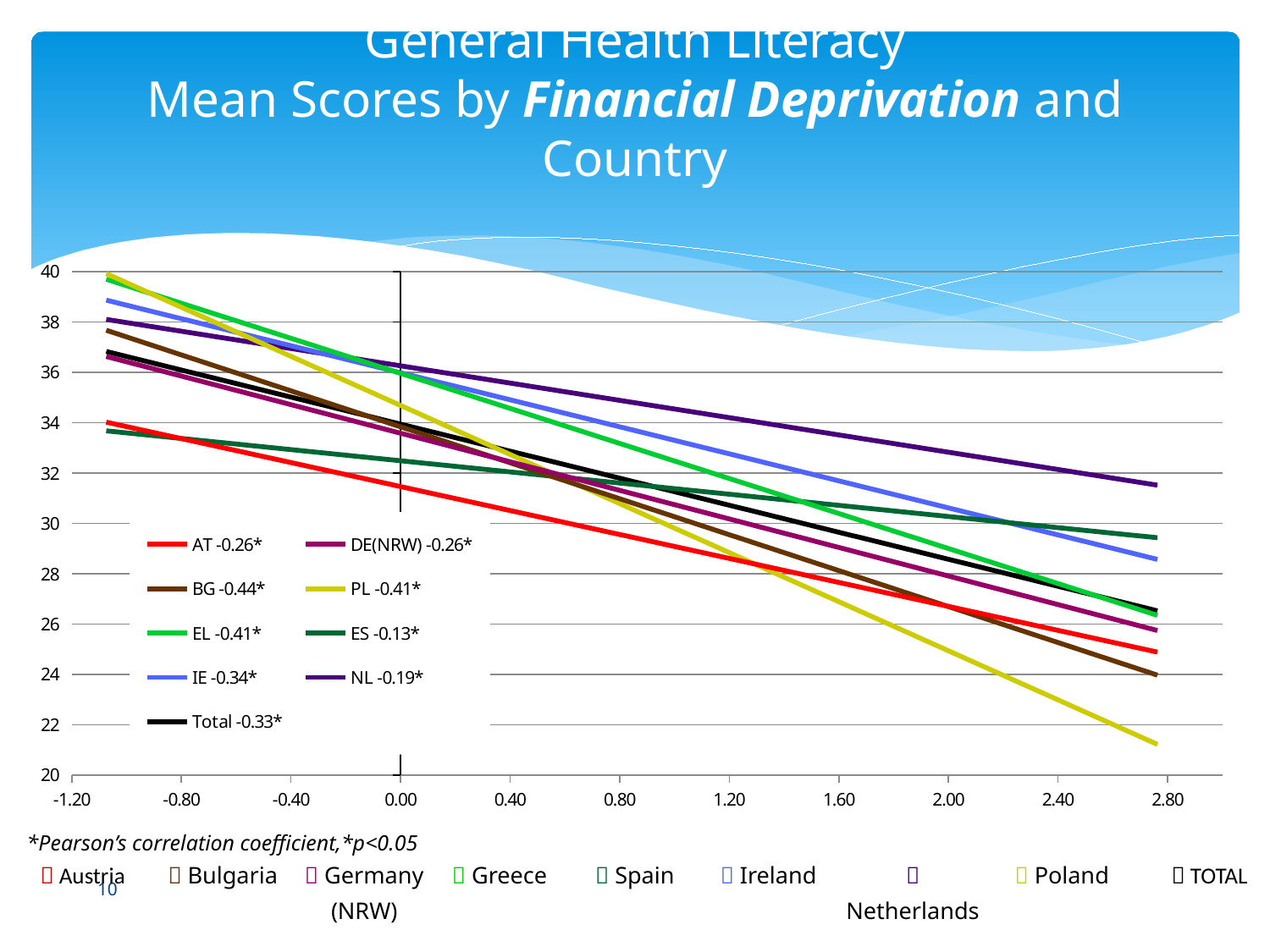
At the right end of the chart, which line is higher: ES or AT? ES Is the value of the PL line at the left end of the chart greater or less than 38? greater How many series does the chart legend list? 9 Which series has the lowest value at the right end of the chart (around 2.80)? PL What correlation coefficient is shown in the legend for BG? -0.44* What correlation coefficient is shown in the legend for Total? -0.33* Which series has the highest value at the right end of the chart (around 2.80)? NL Is the value of the BG line at the left end of the chart greater or less than 36? greater Is the value of the NL line at the right end of the chart greater or less than 30? greater What kind of chart is shown on the slide? line chart Do the plotted lines rise or fall as the x-axis value increases? fall